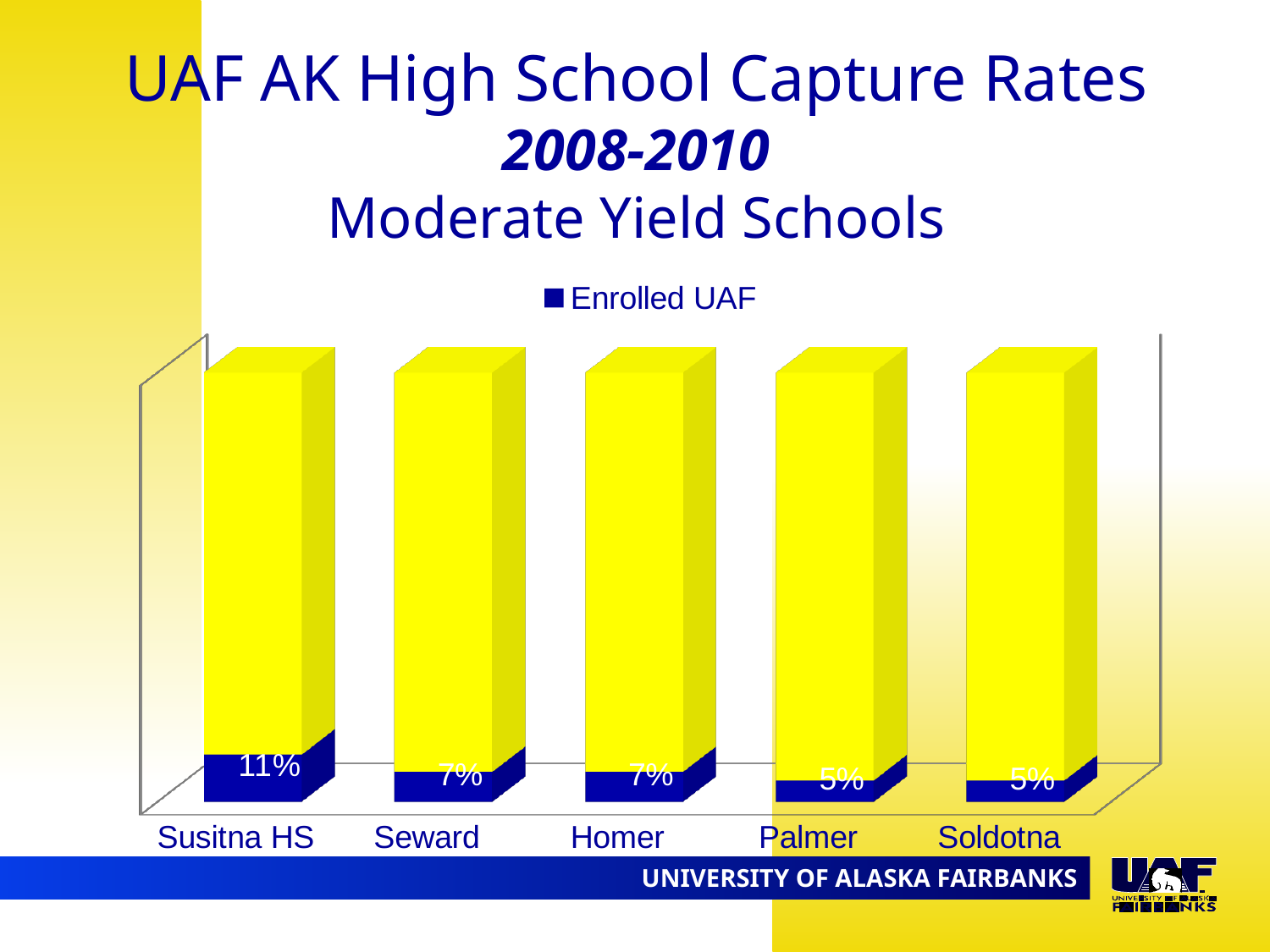
What is the Enrolled UAF value for Soldotna? 5% How many series does the chart legend list? 1 What is the Enrolled UAF value for Palmer? 5% What is the Enrolled UAF value for Susitna HS? 11% What kind of chart is shown on the slide? Bar chart What is the Enrolled UAF value for Seward? 7% Which has a larger Enrolled UAF value, Susitna HS or Seward? Susitna HS Do the Enrolled UAF values rise or fall from Susitna HS to Soldotna along the x axis? Fall Which school has the highest Enrolled UAF capture rate? Susitna HS How many schools are shown on the x axis of the chart? 5 What is the difference between the Enrolled UAF values for Susitna HS and Palmer? 6 percentage points What is the Enrolled UAF value for Homer? 7%